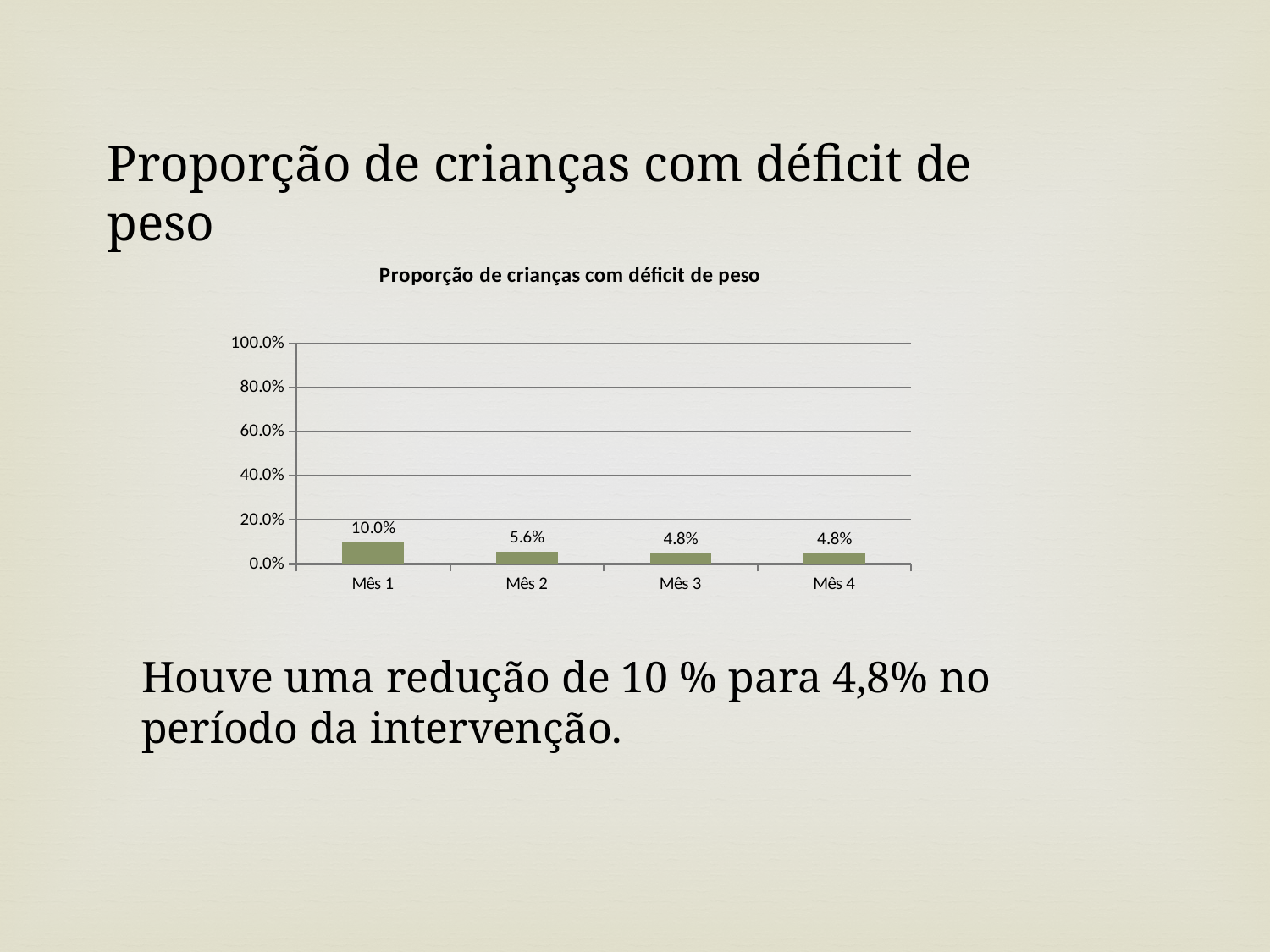
Do the values rise or fall from Mês 1 to Mês 4? Fall What is the difference between the values for Mês 1 and Mês 2? 4.4% What is the difference between the values for Mês 1 and Mês 4? 5.2% What is the value for Mês 2? 5.6% What is the value for Mês 4? 4.8% What is the value for Mês 3? 4.8% Which month has the highest proportion of children with weight deficit? Mês 1 Which is larger, the value for Mês 1 or the value for Mês 3? Mês 1 What kind of chart is shown on the slide? Bar chart What is the value for Mês 1? 10.0% How many months are shown on the x axis? 4 Is the value for Mês 1 greater or less than 20.0%? less